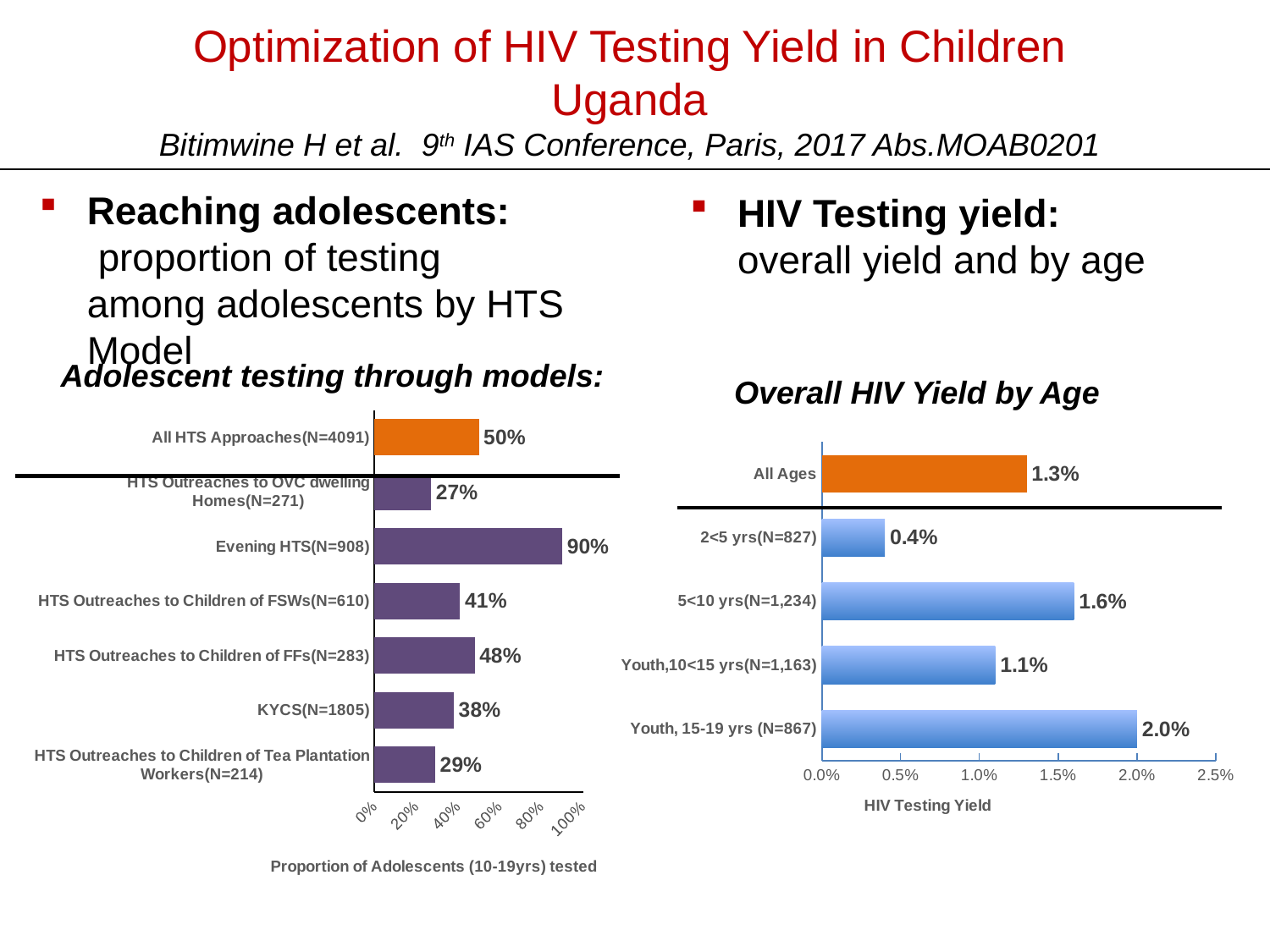
In the 'Overall HIV Yield by Age' chart, what is the value for All Ages? 1.3% In the 'Adolescent testing through models' chart, what is the value for Evening HTS(N=908)? 90% In the 'Overall HIV Yield by Age' chart, what is the difference between the yield for Youth, 15-19 yrs (N=867) and 2<5 yrs(N=827)? 1.6% What is the x-axis title of the 'Overall HIV Yield by Age' chart? HIV Testing Yield In the 'Overall HIV Yield by Age' chart, which age group has the lowest HIV testing yield? 2<5 yrs(N=827) In the 'Adolescent testing through models' chart, which category has the highest proportion of adolescents tested? Evening HTS(N=908) In the 'Adolescent testing through models' chart, what is the difference between the values for Evening HTS(N=908) and KYCS(N=1805)? 52% What kind of chart is 'Overall HIV Yield by Age'? Bar chart How many categories are shown in the 'Adolescent testing through models' chart? 7 In the 'Adolescent testing through models' chart, which category has the lowest proportion of adolescents tested? HTS Outreaches to OVC dwelling Homes(N=271) In the 'Overall HIV Yield by Age' chart, what is the HIV testing yield for Youth, 15-19 yrs (N=867)? 2.0% In the 'Adolescent testing through models' chart, which is larger: HTS Outreaches to Children of FSWs(N=610) or HTS Outreaches to Children of FFs(N=283)? HTS Outreaches to Children of FFs(N=283)